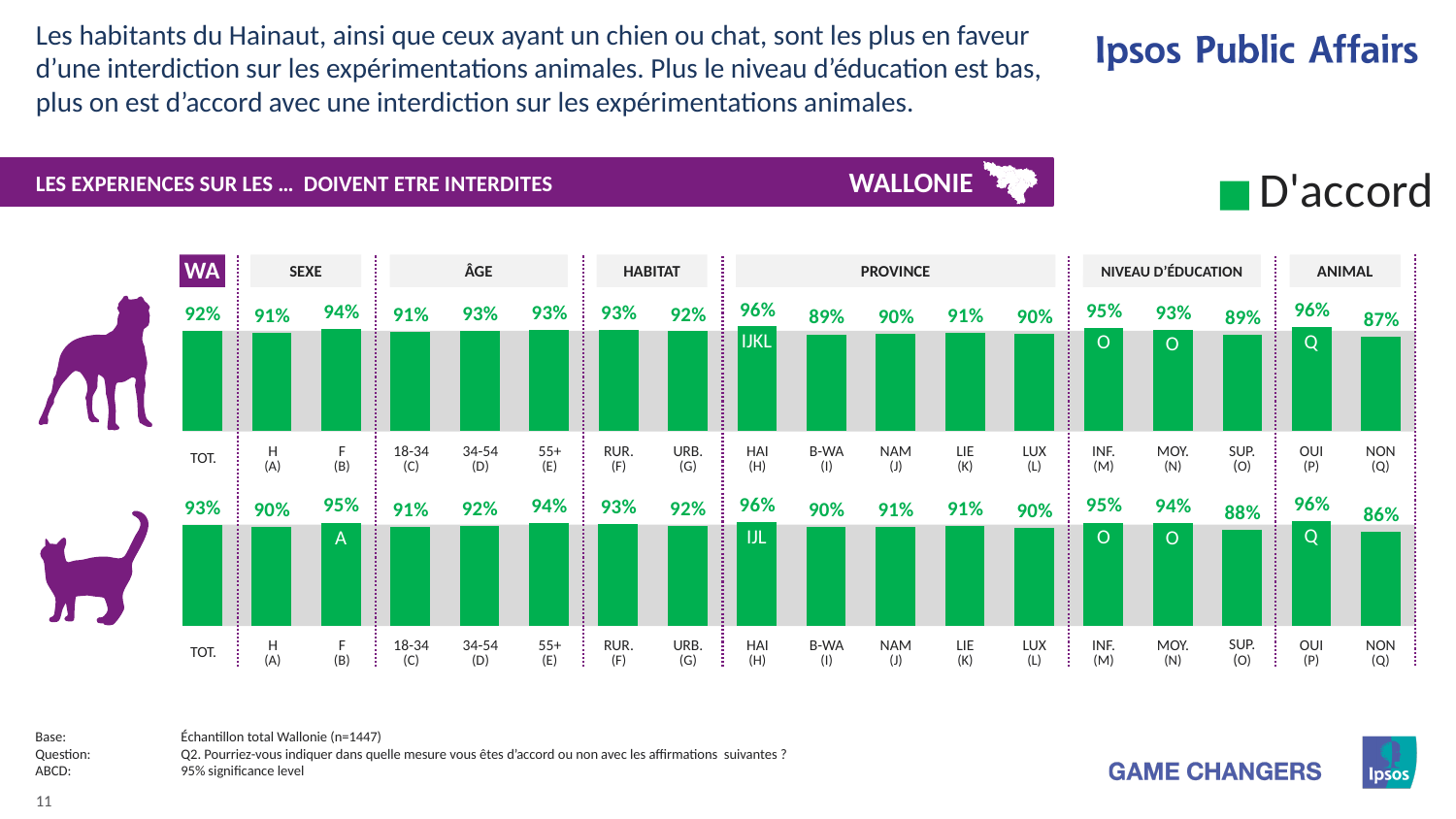
In the top chart (dog), what is the value for the total (TOT.) Wallonia? 92% In the bottom chart (cat), what is the value for NON (Q) in the ANIMAL group? 86% In the bottom chart (cat), what is the difference between the values for OUI (P) and NON (Q)? 10% In the top chart (dog), which province has the lowest value? B-WA (I) In the bottom chart (cat), what is the value for the total (TOT.) Wallonia? 93% How many categories are plotted in the PROVINCE group of the top chart (dog)? 5 What type of chart is used on this slide? Bar chart In the bottom chart (cat), which is larger, the value for 55+ (E) or 18-34 (C)? 55+ (E) In the top chart (dog), what is the difference between the values for F (B) and H (A)? 3% In the bottom chart (cat), which education level (NIVEAU D'ÉDUCATION) has the highest value? INF. (M) In the top chart (dog), what is the value for the province HAI (H)? 96% In the top chart (dog), which is larger, the value for RUR. (F) or URB. (G)? RUR. (F)